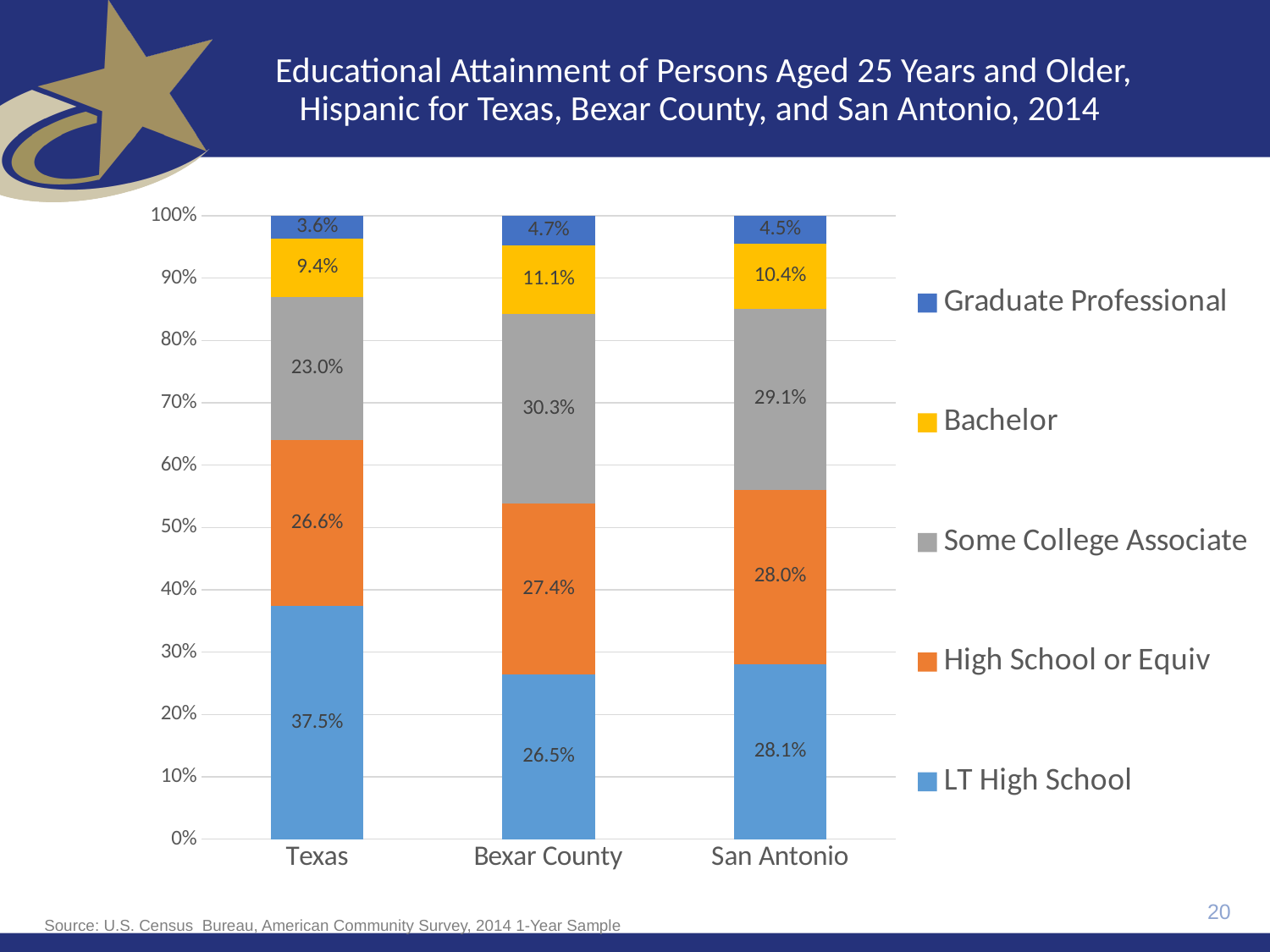
Which colour represents High School or Equiv in the chart? Orange How many areas are shown on the x axis? 3 What is the value for Bachelor in Texas? 9.4% How many series does the legend list? 5 What is the value for Graduate Professional in San Antonio? 4.5% What is the value for Some College Associate in Bexar County? 30.3% What is the difference between the LT High School values for Texas and Bexar County? 11.0 percentage points What kind of chart is shown on the slide? Stacked bar chart What is the value for LT High School in Texas? 37.5% Which area has the lowest value for Graduate Professional? Texas Which is larger, the Bachelor value for Bexar County or for San Antonio? Bexar County Which area has the highest value for LT High School? Texas